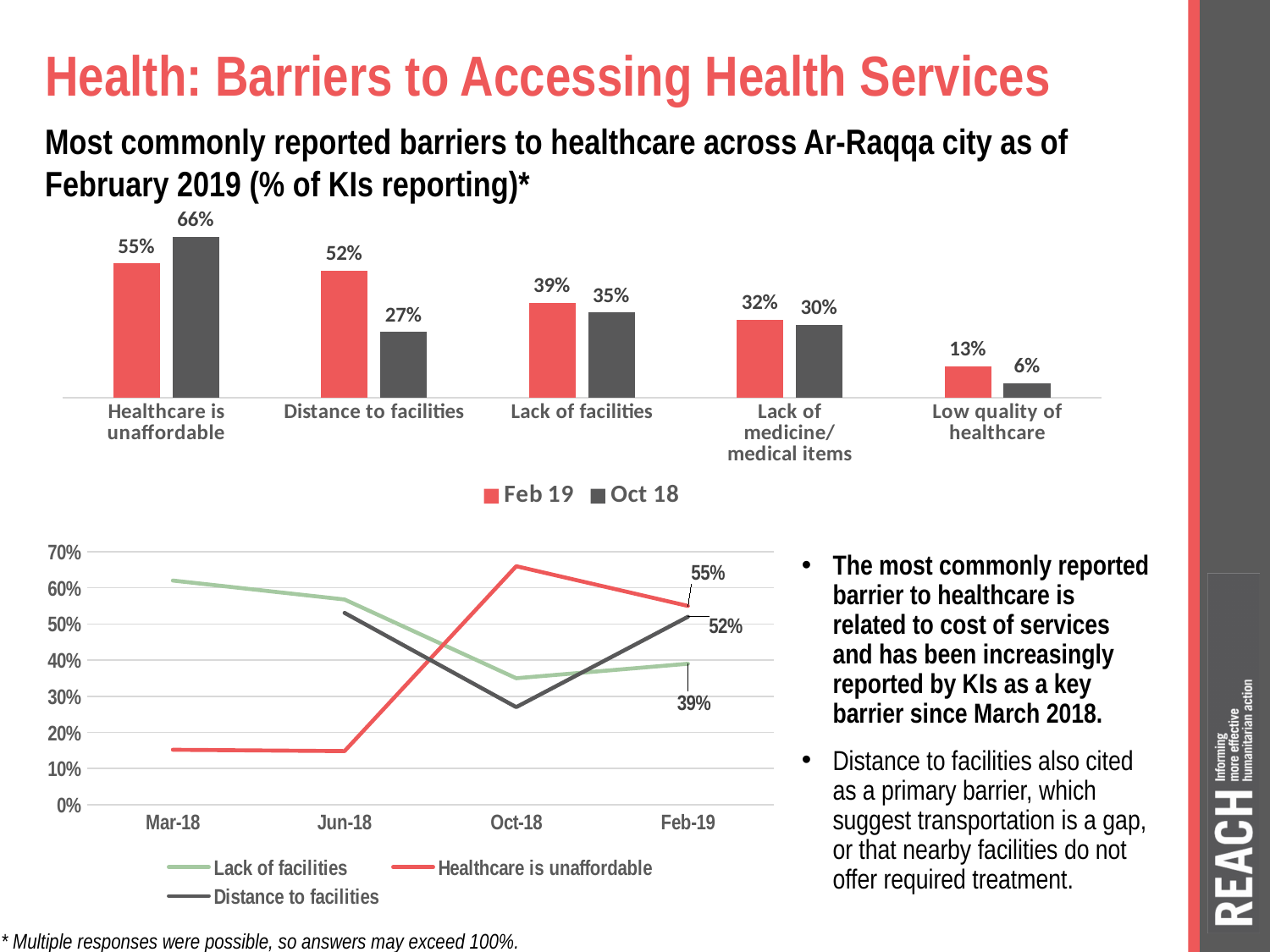
In the bottom line chart, what is the Feb-19 value for 'Lack of facilities'? 39% In the top bar chart, is the Feb 19 value for 'Lack of facilities' larger or smaller than its Oct 18 value? larger In the top bar chart, which barrier has the lowest Feb 19 value? Low quality of healthcare In the bottom line chart, does the 'Healthcare is unaffordable' line rise or fall between Jun-18 and Oct-18? rise In the top bar chart, what percentage of KIs reported 'Healthcare is unaffordable' in Feb 19? 55% In the top bar chart, what was the Oct 18 value for 'Distance to facilities'? 27% What type of chart is the bottom chart on the slide? line chart In the top bar chart, what is the difference between the Feb 19 and Oct 18 values for 'Distance to facilities'? 25% How many barrier categories are shown in the top bar chart? 5 How many series does the legend of the top bar chart list? 2 In the top bar chart, which barrier has the highest Oct 18 value? Healthcare is unaffordable In the bottom line chart, is the Mar-18 value for 'Healthcare is unaffordable' greater or less than 20%? less